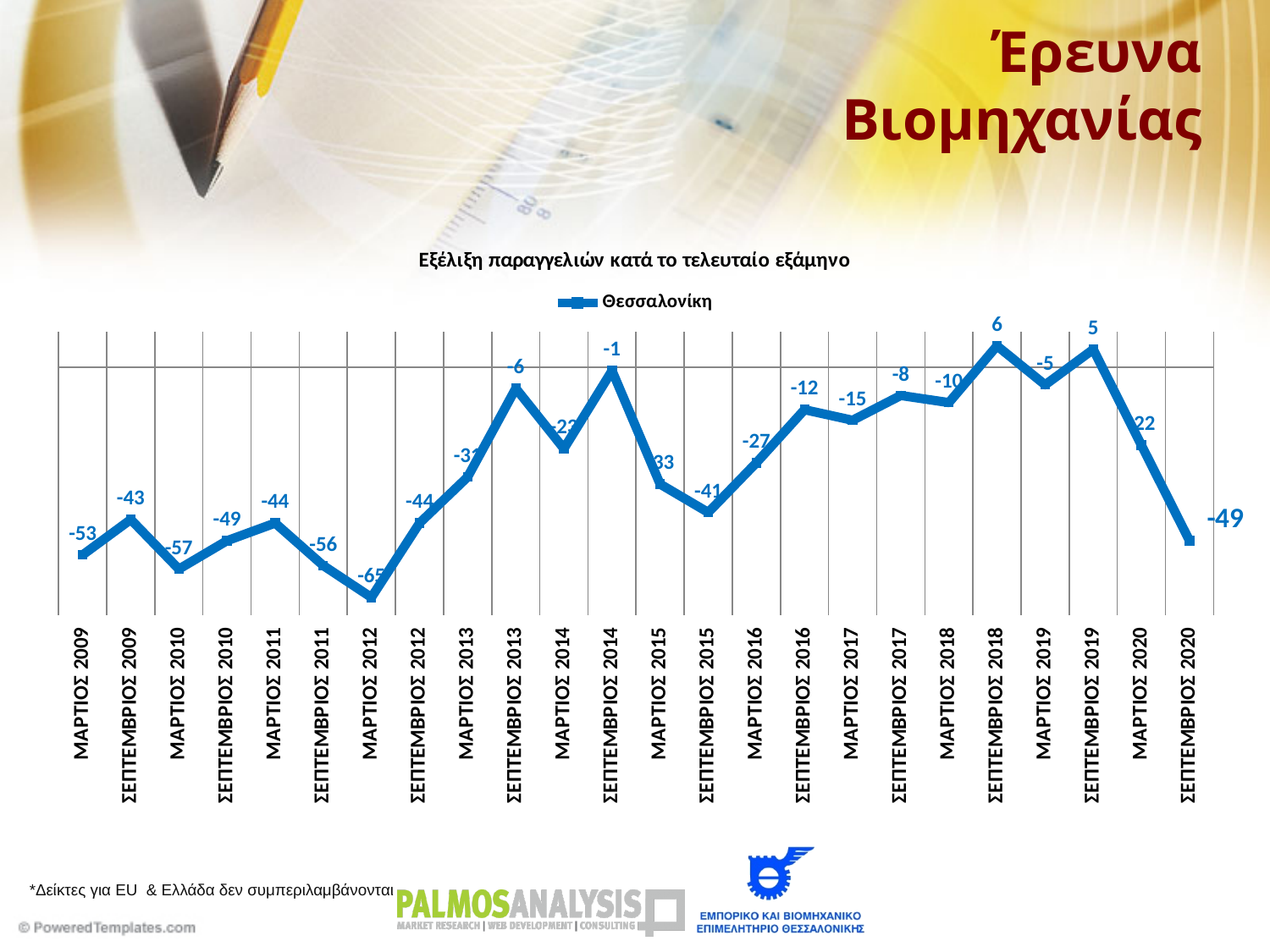
What type of chart is shown on the slide? line chart Which period has the lowest value? ΜΑΡΤΙΟΣ 2012 How many series does the legend list? 1 What is the value for ΜΑΡΤΙΟΣ 2012? -65 What is the value for ΣΕΠΤΕΜΒΡΙΟΣ 2014? -1 Which period has the highest value? ΣΕΠΤΕΜΒΡΙΟΣ 2018 What is the value for ΣΕΠΤΕΜΒΡΙΟΣ 2020? -49 What is the difference between the values for ΣΕΠΤΕΜΒΡΙΟΣ 2018 and ΜΑΡΤΙΟΣ 2012? 71 Which is larger, the value for ΣΕΠΤΕΜΒΡΙΟΣ 2019 or the value for ΜΑΡΤΙΟΣ 2019? ΣΕΠΤΕΜΒΡΙΟΣ 2019 What is the title of the chart? Εξέλιξη παραγγελιών κατά το τελευταίο εξάμηνο How many periods are plotted on the x axis? 24 What is the value for ΜΑΡΤΙΟΣ 2009? -53